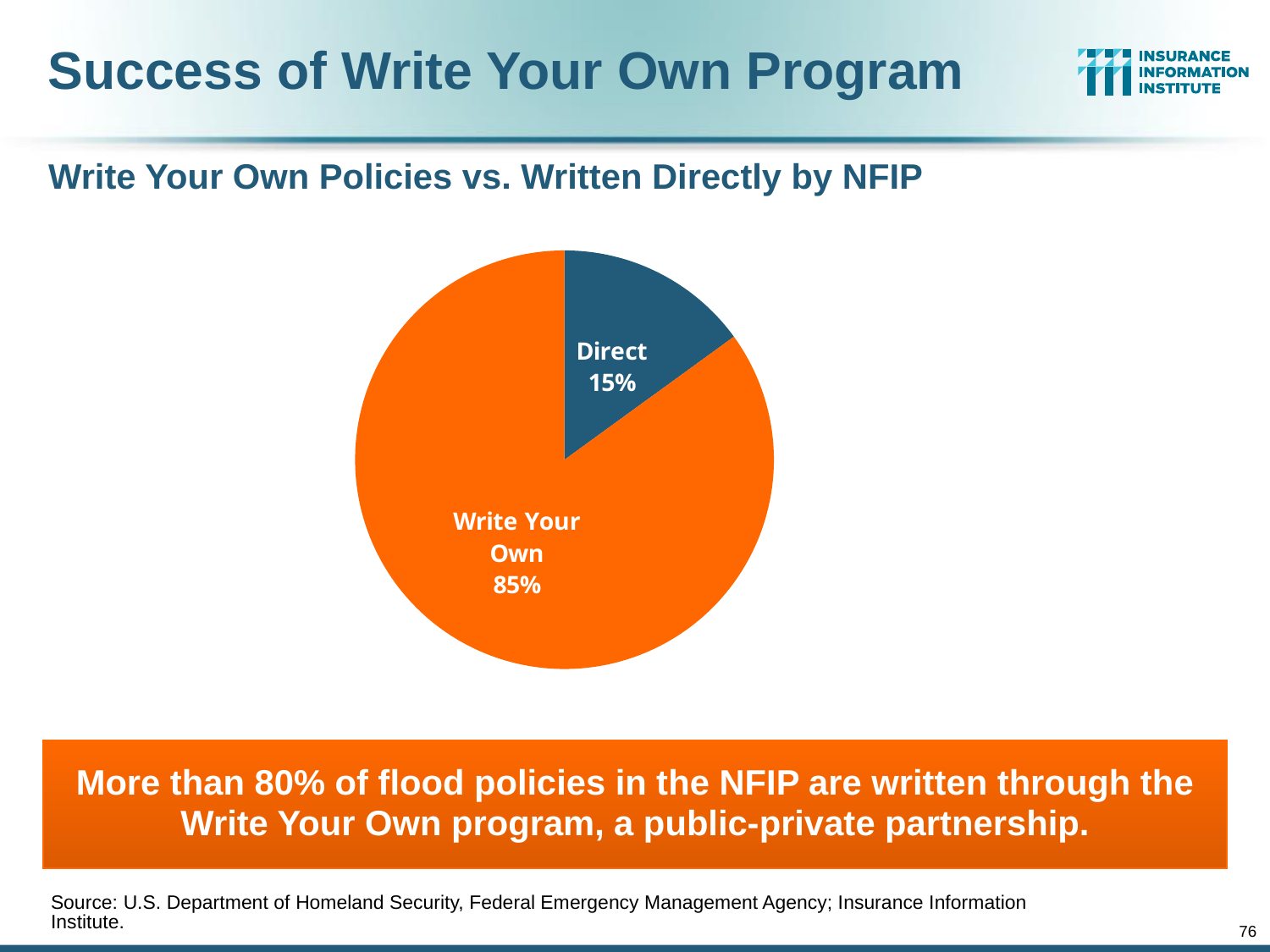
What colour is the Direct slice of the pie? dark blue What is the total of the two slices shown in the pie chart? 100% Which slice of the pie is the largest? Write Your Own Which slice of the pie is the smallest? Direct What kind of chart is shown on the slide? pie chart What share of the pie does Direct represent? 15% What is the difference in percentage points between the Write Your Own slice and the Direct slice? 70 What is the title of the chart? Write Your Own Policies vs. Written Directly by NFIP Which is larger, the Write Your Own slice or the Direct slice? Write Your Own How many slices does the pie chart have? 2 What share of the pie does Write Your Own represent? 85%